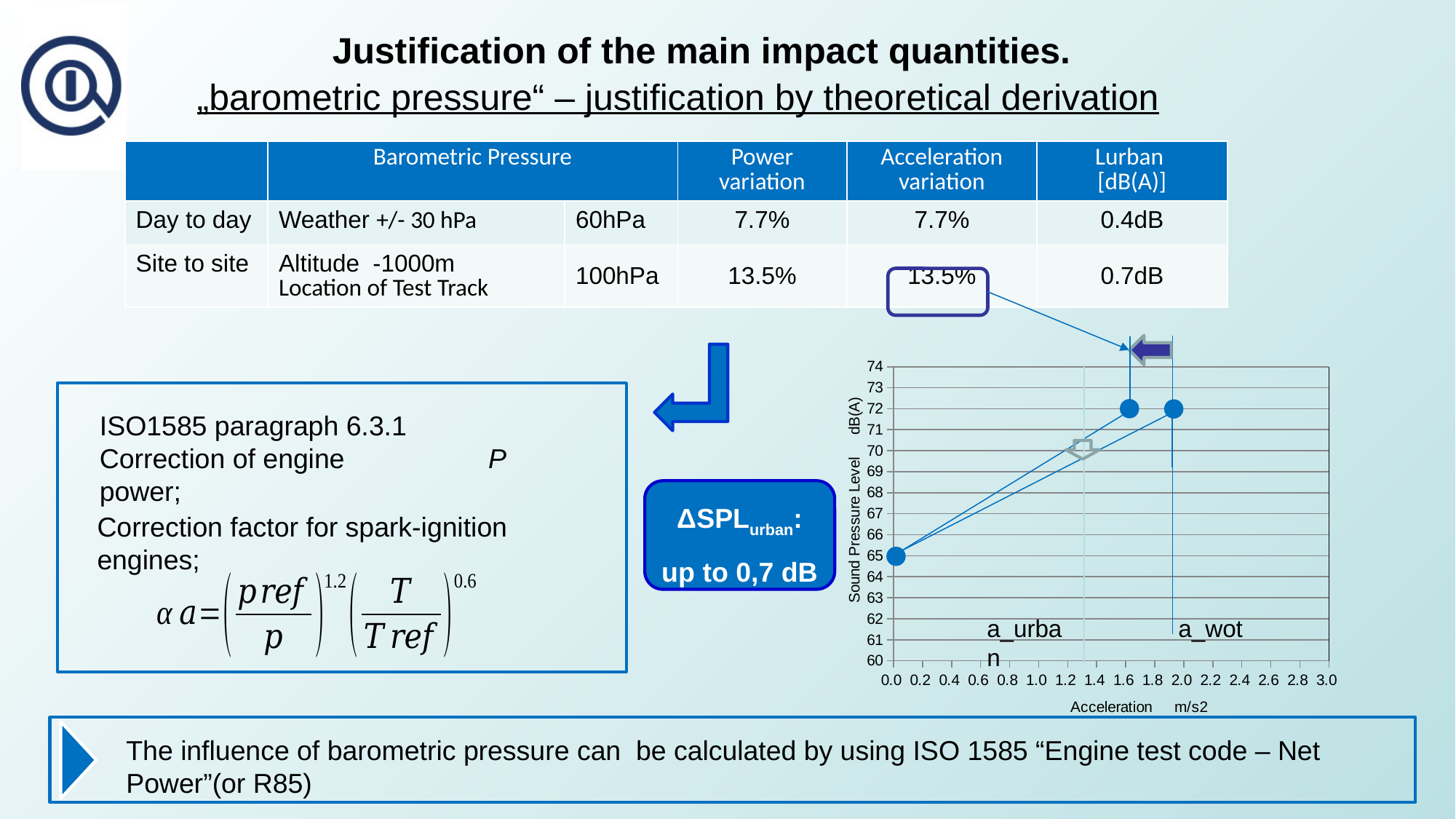
What is the sound pressure level of the point plotted at acceleration 0.0? 65 Is the sound pressure level at a_wot greater or less than 70? greater What is the label of the vertical axis of the chart? Sound Pressure Level dB(A) Which point has the lower sound pressure level: the one at acceleration 0.0 or the one at a_urban? the one at acceleration 0.0 What is the sound pressure level of the point plotted at a_wot? 72 What is the highest value shown on the vertical axis of the chart? 74 What is the label of the horizontal axis of the chart? Acceleration m/s2 How many data points are plotted on the chart? 3 What kind of chart is shown on the slide? scatter chart Does the sound pressure level rise or fall as acceleration increases along the x axis? rise Is the sound pressure level at acceleration 0.0 greater or less than 70? less Is the acceleration of the a_wot point greater or less than 1.8 m/s2? greater